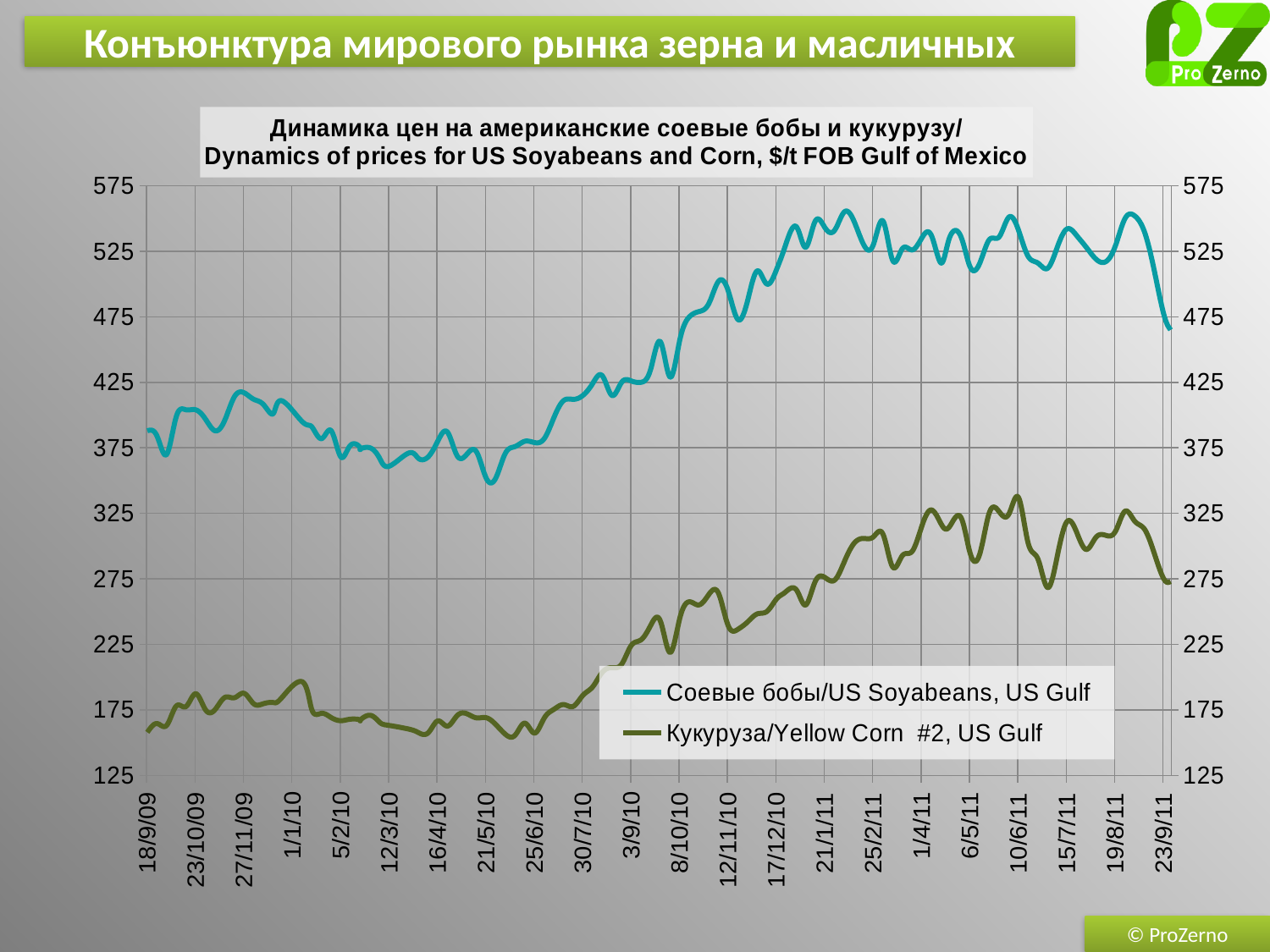
Is the value for Yellow Corn at 10/6/11 greater or less than 300? greater Is the value for Yellow Corn at 23/9/11 greater or less than 325? less What unit of price is stated in the chart title? $/t FOB Gulf of Mexico How many series does the legend list? 2 Is the value for US Soyabeans at 21/1/11 greater or less than 525? greater What kind of chart is shown on the slide? line chart Does the Yellow Corn price rise or fall between 25/6/10 and 17/12/10? rise Which series has the higher value at 21/1/11, US Soyabeans or Yellow Corn? US Soyabeans Does the US Soyabeans price rise or fall between 19/8/11 and 23/9/11? fall Which series is shown in the darker green line? Кукуруза/Yellow Corn #2, US Gulf